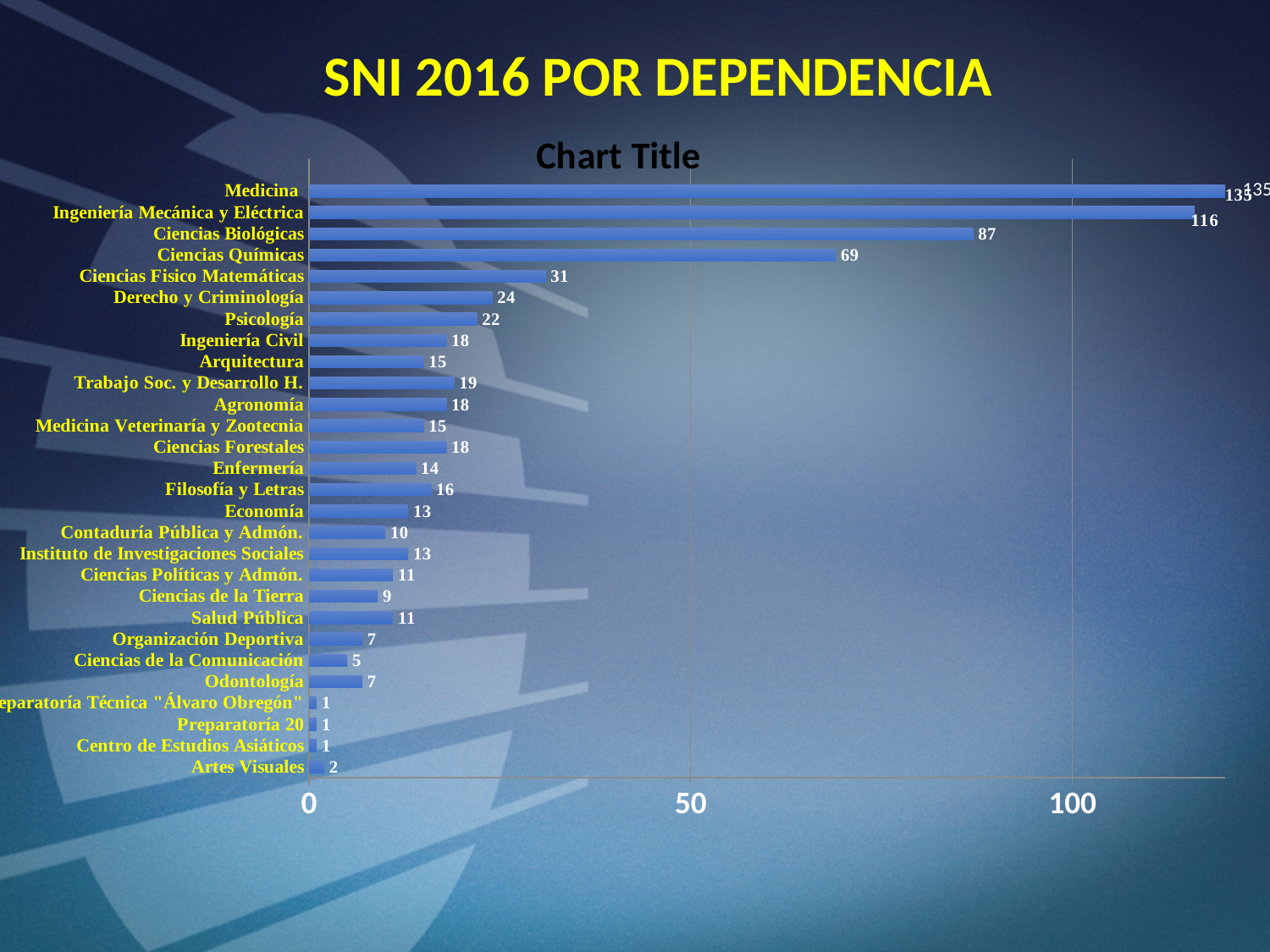
What is the value for Ciencias Biológicas? 87 What is the difference between the values for Ciencias Químicas and Ciencias Fisico Matemáticas? 38 What kind of chart is shown on the slide? bar chart What is the difference between the values for Ingeniería Mecánica y Eléctrica and Ciencias Biológicas? 29 How many categories are shown in the chart? 28 What is the value for Ciencias Químicas? 69 What is the value for Psicología? 22 What is the value for Ingeniería Mecánica y Eléctrica? 116 Which category has the highest value? Medicina Is the value for Ciencias Biológicas greater or less than 50? greater What is the value for Odontología? 7 Which is larger, the value for Derecho y Criminología or the value for Psicología? Derecho y Criminología